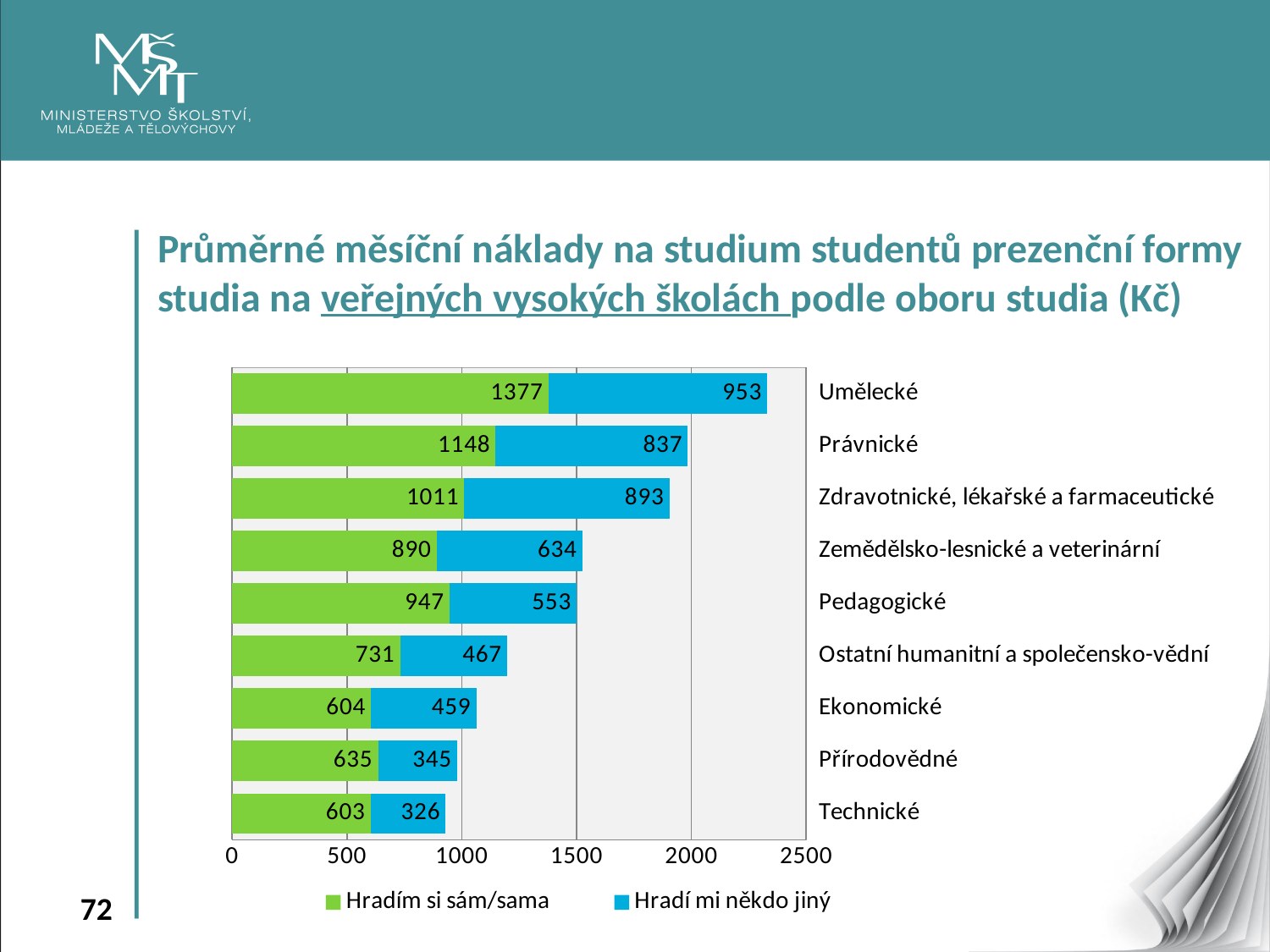
How many series does the legend list? 2 What is the difference between the "Hradím si sám/sama" values for Právnické and Pedagogické? 201 Which is larger: the "Hradí mi někdo jiný" value for Ekonomické or for Přírodovědné? Ekonomické What is the value of "Hradím si sám/sama" for Umělecké? 1377 Which field of study has the lowest value for "Hradí mi někdo jiný"? Technické What is the value of "Hradí mi někdo jiný" for Zdravotnické, lékařské a farmaceutické? 893 What is the value of "Hradí mi někdo jiný" for Technické? 326 What is the total of the stacked bar for Technické? 929 Which field of study has the highest value for "Hradím si sám/sama"? Umělecké What kind of chart is shown on the slide? Stacked bar chart How many fields of study are shown in the chart? 9 What is the total of the stacked bar for Umělecké? 2330